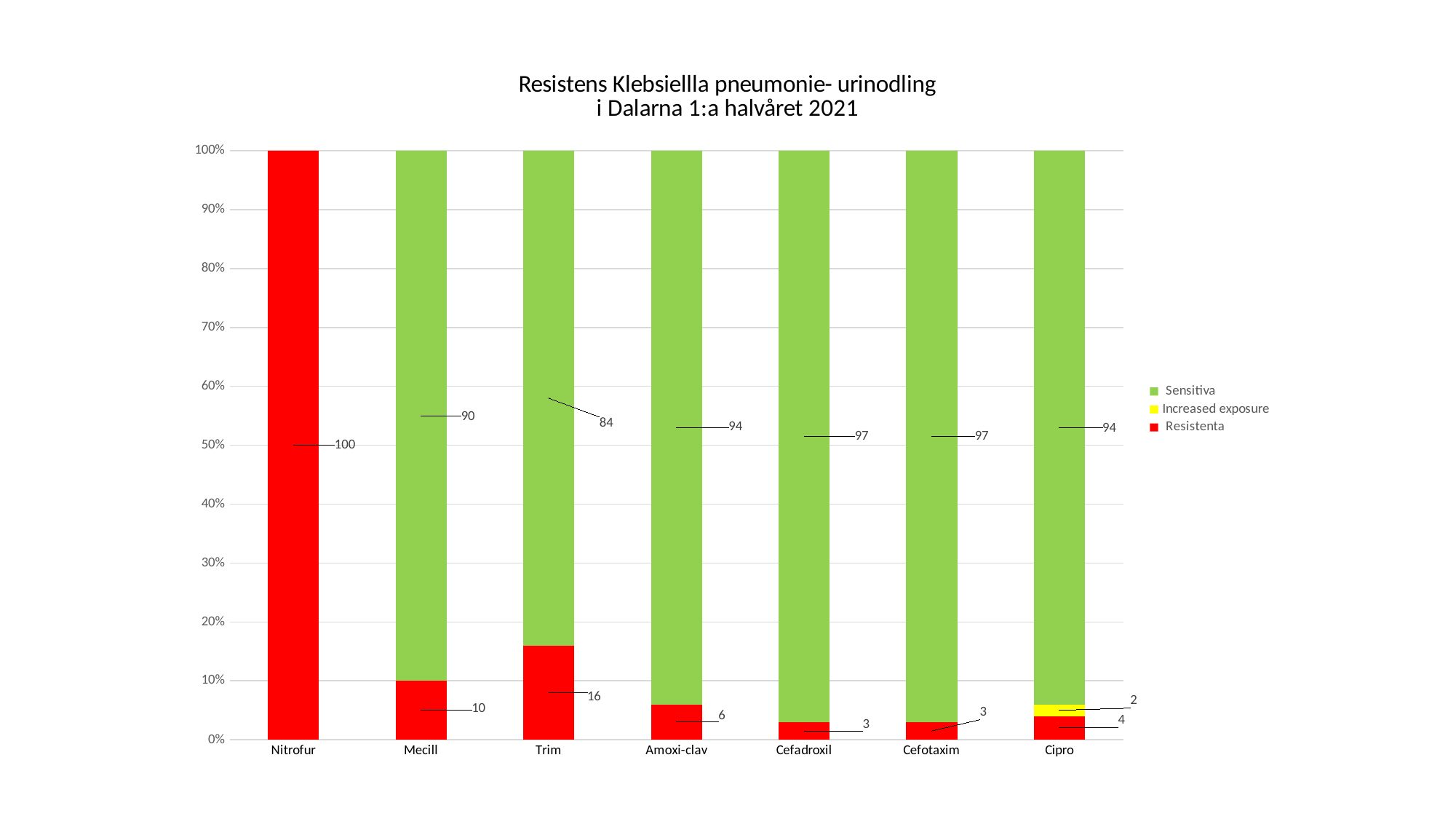
Which category has the highest Resistenta value? Nitrofur Excluding Nitrofur, which category has the lowest Sensitiva value? Trim How many series does the legend list? 3 What is the difference between the Resistenta values for Trim and Mecill? 6 What is the Increased exposure value for Cipro? 2 Which has the larger Resistenta value, Mecill or Amoxi-clav? Mecill Which colour represents the Resistenta series in the legend? Red What is the Sensitiva value for Mecill? 90 How many categories are shown on the x axis? 7 What is the Resistenta value for Trim? 16 What is the total of the stacked bar for Cipro? 100 What kind of chart is shown on the slide? Stacked bar chart